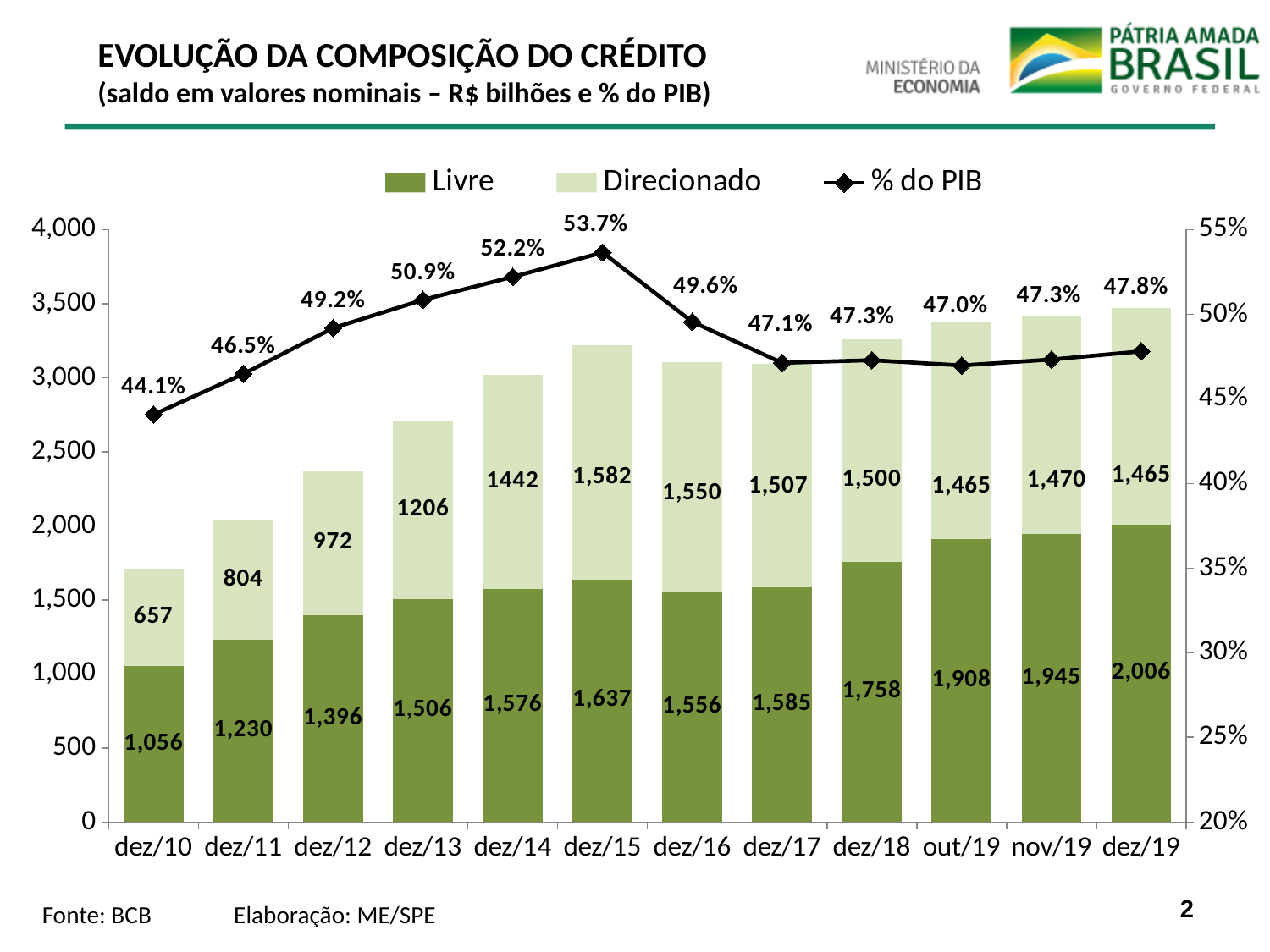
Does the % do PIB line rise or fall from dez/15 to dez/17? Falls Which period has the lowest value for the Livre series? dez/10 What is the value of the Direcionado series for dez/15? 1,582 What kind of chart is shown on the slide? Stacked bar chart with a line How many periods are shown on the x axis? 12 What is the total of the stacked bar for dez/10 (Livre plus Direcionado)? 1,713 What is the value of the Livre series for dez/19? 2,006 What is the difference between the Livre value for dez/19 and the Livre value for dez/10? 950 Which is larger, the Direcionado value for dez/13 or for dez/14? dez/14 What is the % do PIB value shown for dez/14? 52.2% In which period does the % do PIB line reach its highest value? dez/15 How many series does the legend list? 3